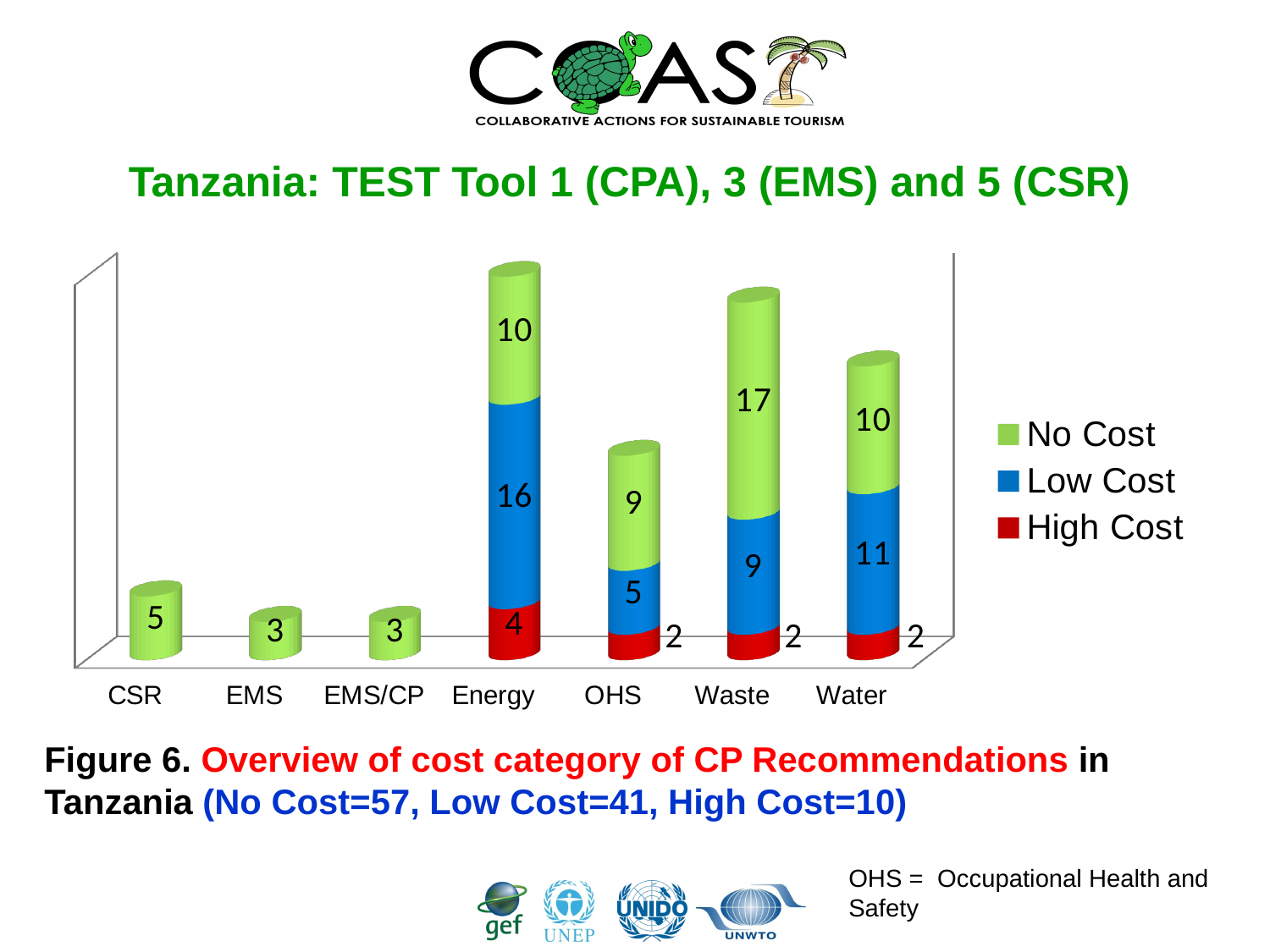
What is the total of the stacked bar for Water? 23 How many series does the chart's legend list? 3 What is the No Cost value for Waste? 17 Which is larger, the No Cost value for OHS or the No Cost value for Water? Water Which category has the highest No Cost value? Waste What kind of chart is shown on the slide? Stacked bar chart What is the total of the stacked bar for Energy? 30 What is the Low Cost value for Energy? 16 How many categories are shown along the x axis of the chart? 7 What is the difference between the Low Cost values for Energy and Water? 5 What is the No Cost value for CSR? 5 What is the High Cost value for Energy? 4